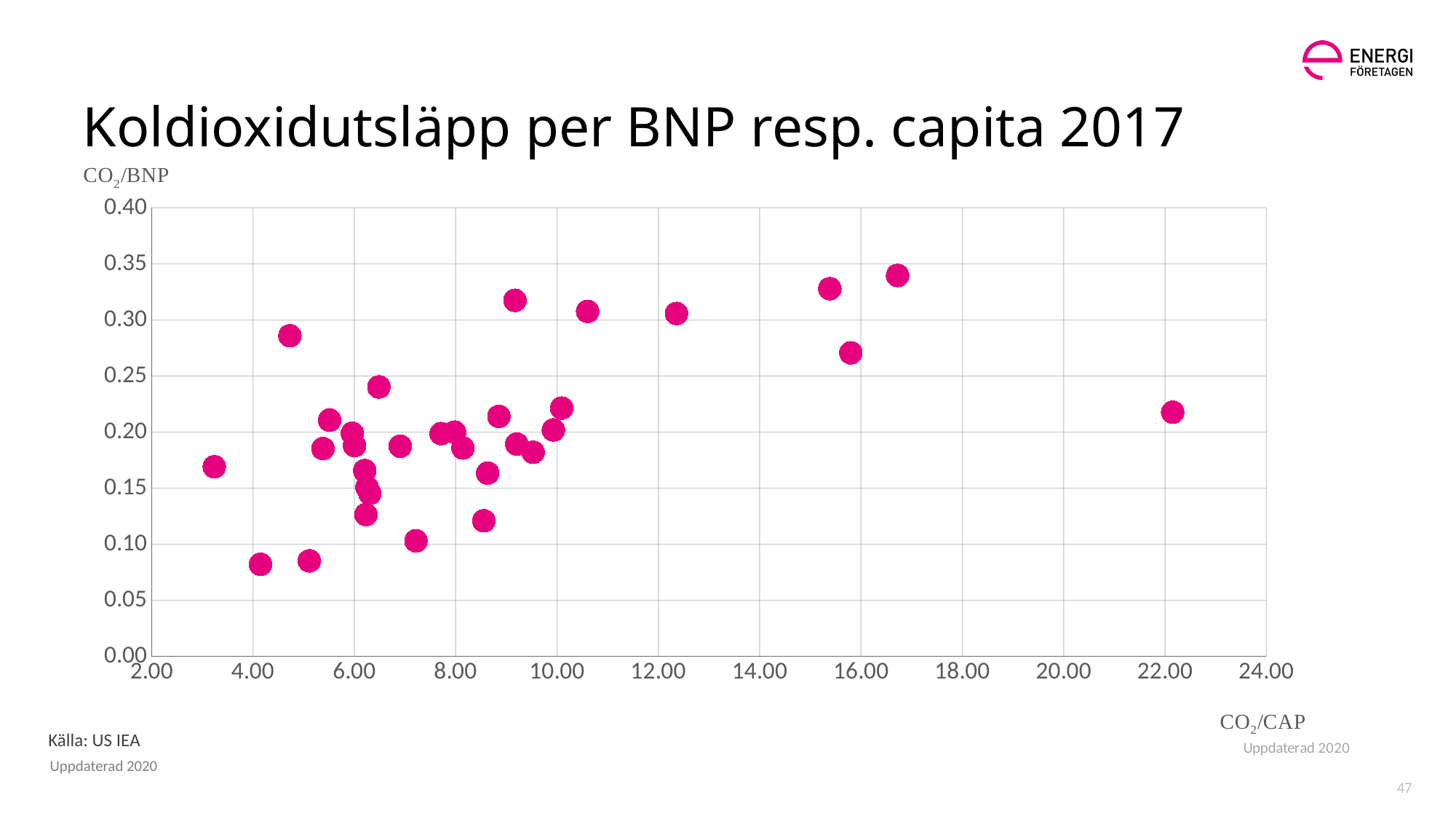
Is the CO2/CAP value of the rightmost point on the chart greater or less than 20.00? greater What is the label of the vertical axis of the chart? CO2/BNP Is the CO2/BNP value of the rightmost point on the chart greater or less than 0.25? less Is the CO2/CAP value of the leftmost point on the chart greater or less than 4.00? less What kind of chart is shown on the slide? scatter chart What is the highest value shown on the horizontal axis of the chart? 24.00 What is the highest value shown on the vertical axis of the chart? 0.40 Do the CO2/BNP values generally rise or fall as CO2/CAP increases along the x axis? rise What is the label of the horizontal axis of the chart? CO2/CAP